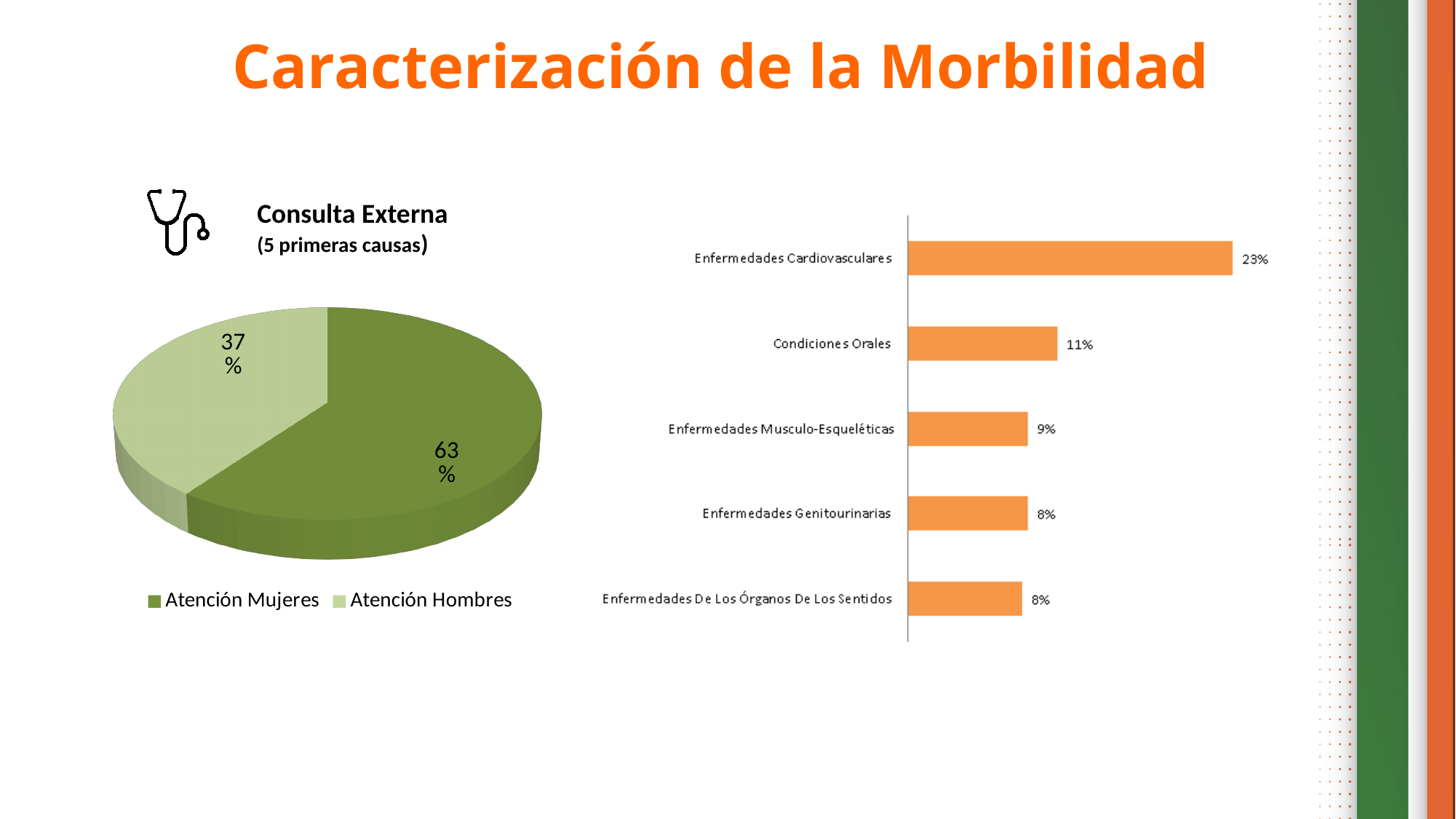
In the pie chart on the left, what is the difference between the Atención Mujeres and Atención Hombres shares? 26% What kind of chart is the chart on the right of the slide? Bar chart In the bar chart on the right, what is the difference between Enfermedades Cardiovasculares and Enfermedades Musculo-Esqueléticas? 14% What kind of chart is the chart on the left of the slide? Pie chart In the pie chart on the left, what share is labelled for Atención Mujeres? 63% In the bar chart on the right, how many categories are shown? 5 In the bar chart on the right, what is the value for Condiciones Orales? 11% In the pie chart on the left, what share is labelled for Atención Hombres? 37% In the pie chart on the left, which slice is larger, Atención Mujeres or Atención Hombres? Atención Mujeres In the bar chart on the right, which category has the highest value? Enfermedades Cardiovasculares How many entries does the legend of the pie chart on the left list? 2 In the bar chart on the right, what is the value for Enfermedades Cardiovasculares? 23%